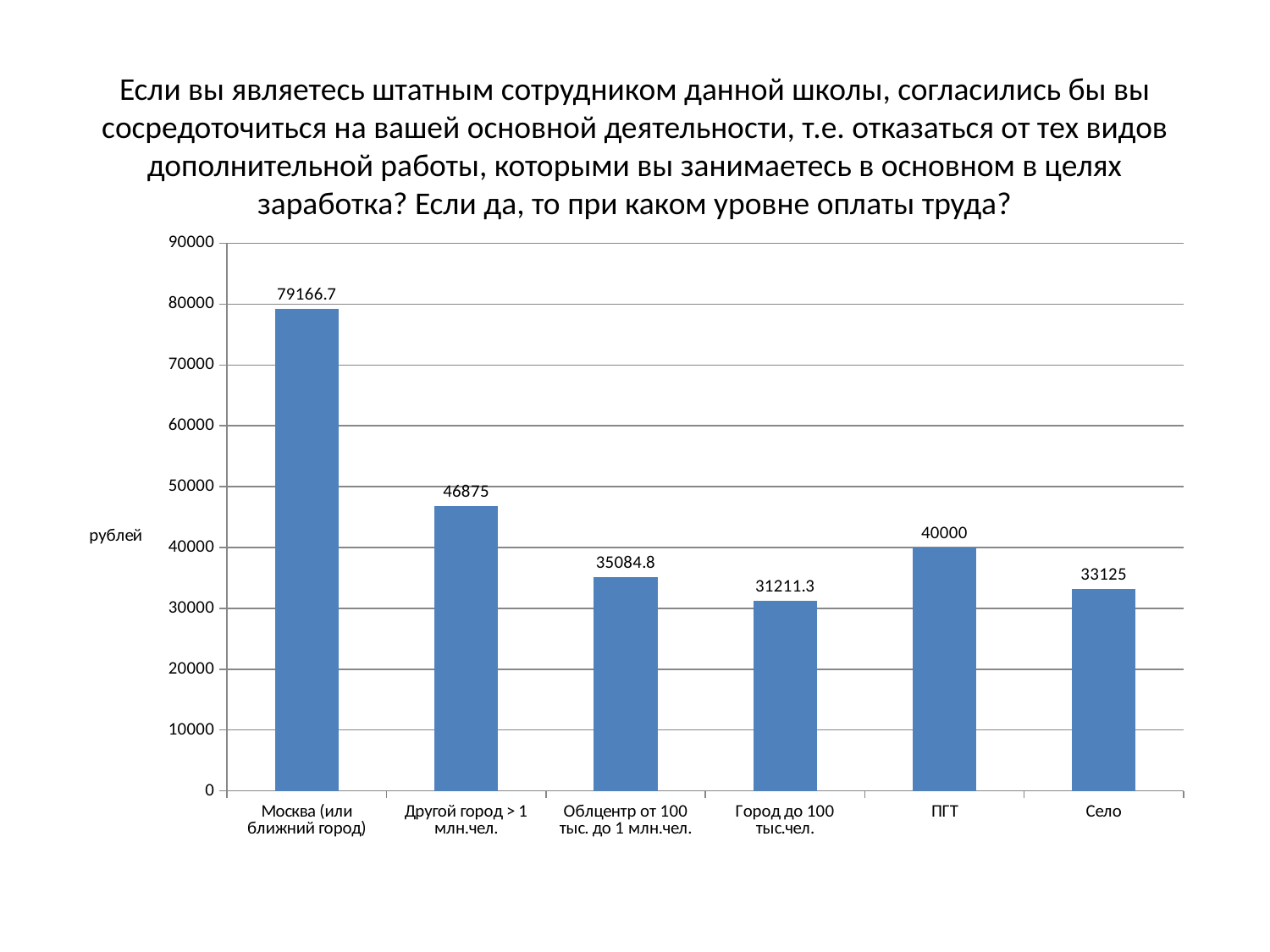
Is the value for Другой город > 1 млн.чел. greater or less than 50000? less Which category has the lowest value? Город до 100 тыс.чел. What is the difference between the values for Москва (или ближний город) and Другой город > 1 млн.чел.? 32291.7 What kind of chart is shown on the slide? bar chart Which category has the highest value? Москва (или ближний город) What is the difference between the values for ПГТ and Село? 6875 What is the value for ПГТ? 40000 How many categories are shown on the x axis? 6 What is the value for Село? 33125 What is the value for Город до 100 тыс.чел.? 31211.3 Which is larger, the value for Облцентр от 100 тыс. до 1 млн.чел. or the value for ПГТ? ПГТ What is the value for Москва (или ближний город)? 79166.7